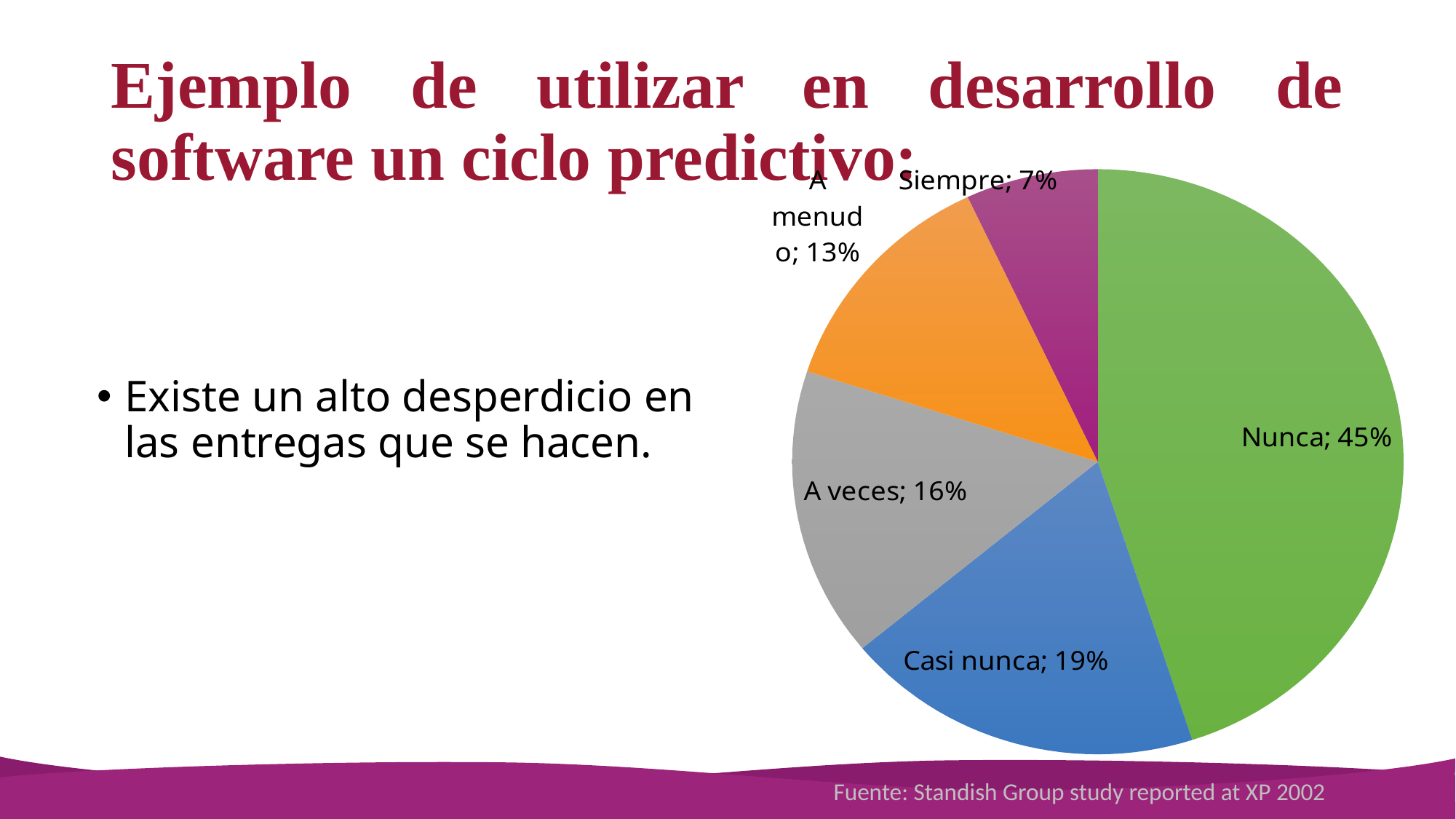
What is the value for Casi nunca? 19% How many slices does the pie chart have? 5 Which category has the largest slice? Nunca What is the value for Nunca? 45% What colour is the Nunca slice? green Which is larger, A veces or A menudo? A veces What is the value for A menudo? 13% Which category has the smallest slice? Siempre What is the difference between the values for Nunca and Casi nunca? 26% What is the value for A veces? 16% What is the value for Siempre? 7% What kind of chart is shown on the slide? pie chart